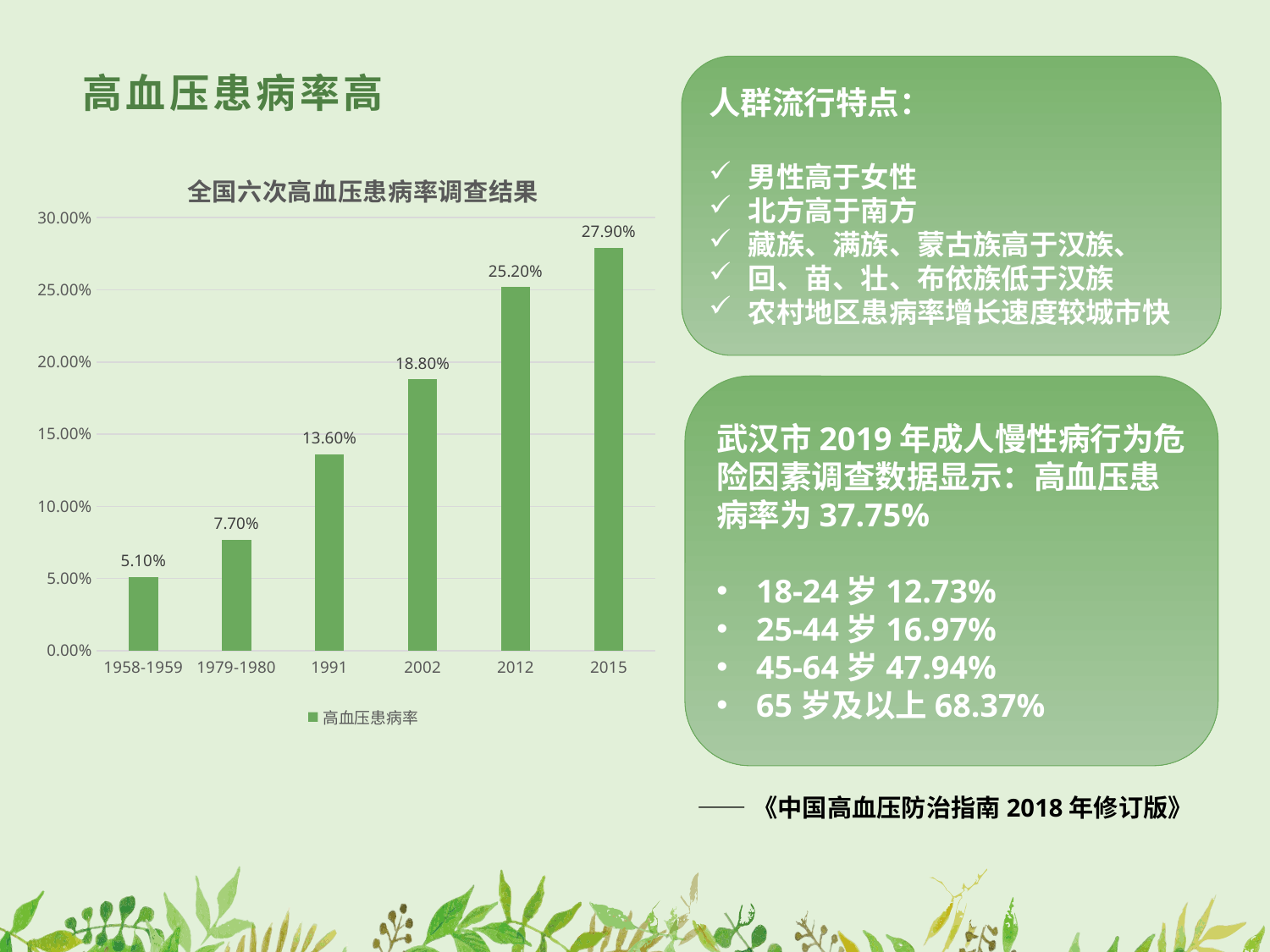
What is the difference between the values for 1979-1980 and 1958-1959? 2.60% What kind of chart is shown on the slide? Bar chart Which period has the highest hypertension prevalence rate? 2015 Is the value for 2012 greater or less than 20.00%? greater What is the difference between the values for 2015 and 2012? 2.70% What is the value shown for 2002? 18.80% What is the hypertension prevalence rate shown for 1991? 13.60% Do the values rise or fall from 1958-1959 to 2015? Rise What is the value shown for 1958-1959? 5.10% How many survey periods are shown on the x axis? 6 Which period has the lowest hypertension prevalence rate? 1958-1959 Which is larger, the value for 2002 or the value for 1991? 2002